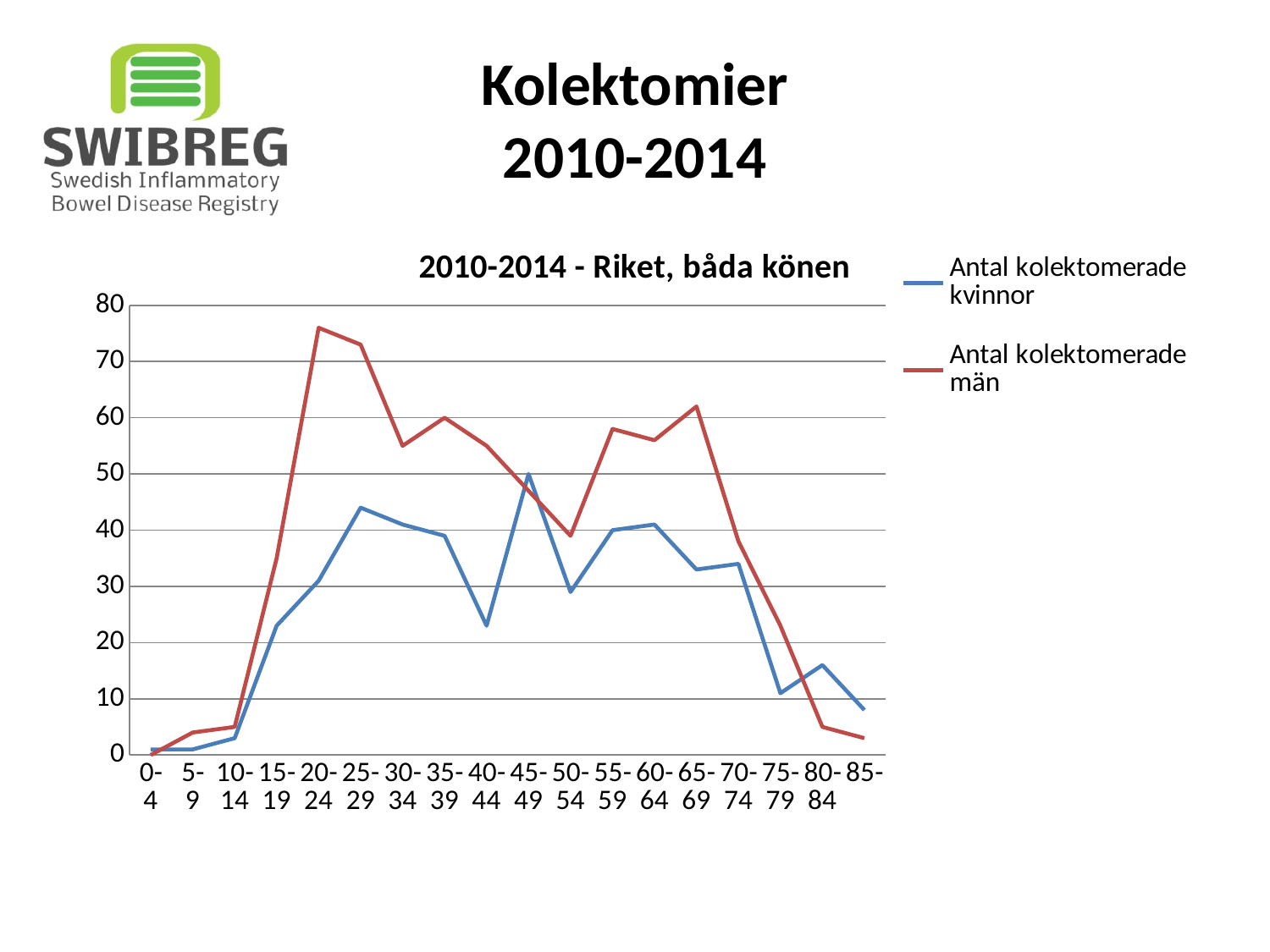
Is the value for Antal kolektomerade män in the 20-24 age group greater or less than 70? greater What is the title shown above the chart's plot area? 2010-2014 - Riket, båda könen Which age group has the highest value for Antal kolektomerade män? 20-24 Is the value for Antal kolektomerade kvinnor in the 40-44 age group greater or less than 30? less How many series does the legend list? 2 Is the value for Antal kolektomerade kvinnor in the 75-79 age group greater or less than 20? less Which age group has the highest value for Antal kolektomerade kvinnor? 45-49 Do the values for Antal kolektomerade män rise or fall from the 65-69 age group to the 85- age group? fall In the 80-84 age group, which series has the higher value, kvinnor or män? kvinnor How many age groups are shown along the x axis? 18 In the 30-34 age group, which series has the higher value, kvinnor or män? män What kind of chart is shown on the slide? line chart